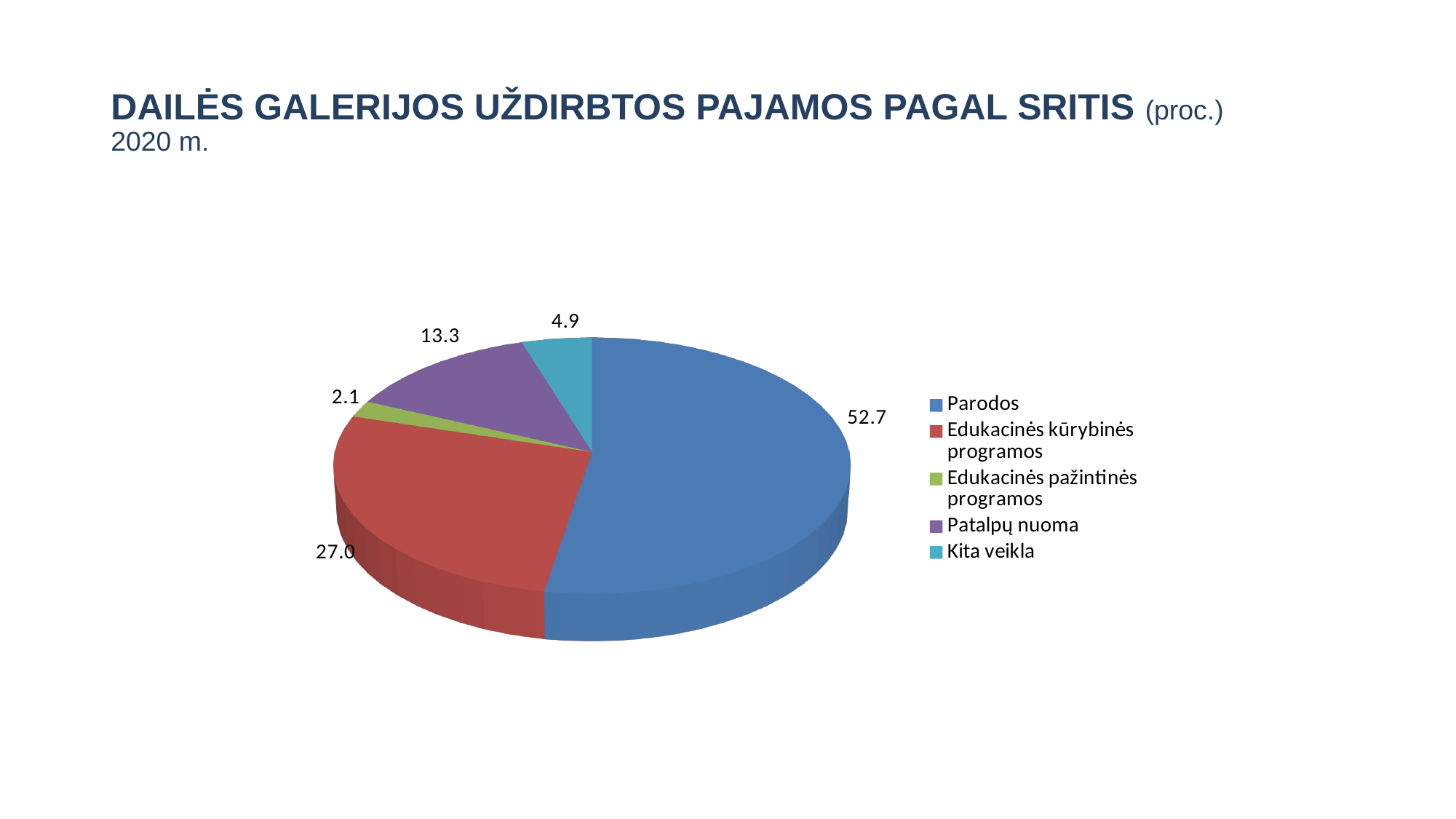
Which category has the smallest share of the pie? Edukacinės pažintinės programos What is the value for Parodos? 52.7 How many categories does the pie chart have? 5 What is the difference between the values for Parodos and Edukacinės kūrybinės programos? 25.7 What type of chart is shown on the slide? Pie chart Which category has the largest share of the pie? Parodos What year does the chart title refer to? 2020 m. Which is larger, the value for Patalpų nuoma or the value for Kita veikla? Patalpų nuoma What is the value for Kita veikla? 4.9 What is the value for Patalpų nuoma? 13.3 What is the value for Edukacinės kūrybinės programos? 27.0 What is the value for Edukacinės pažintinės programos? 2.1